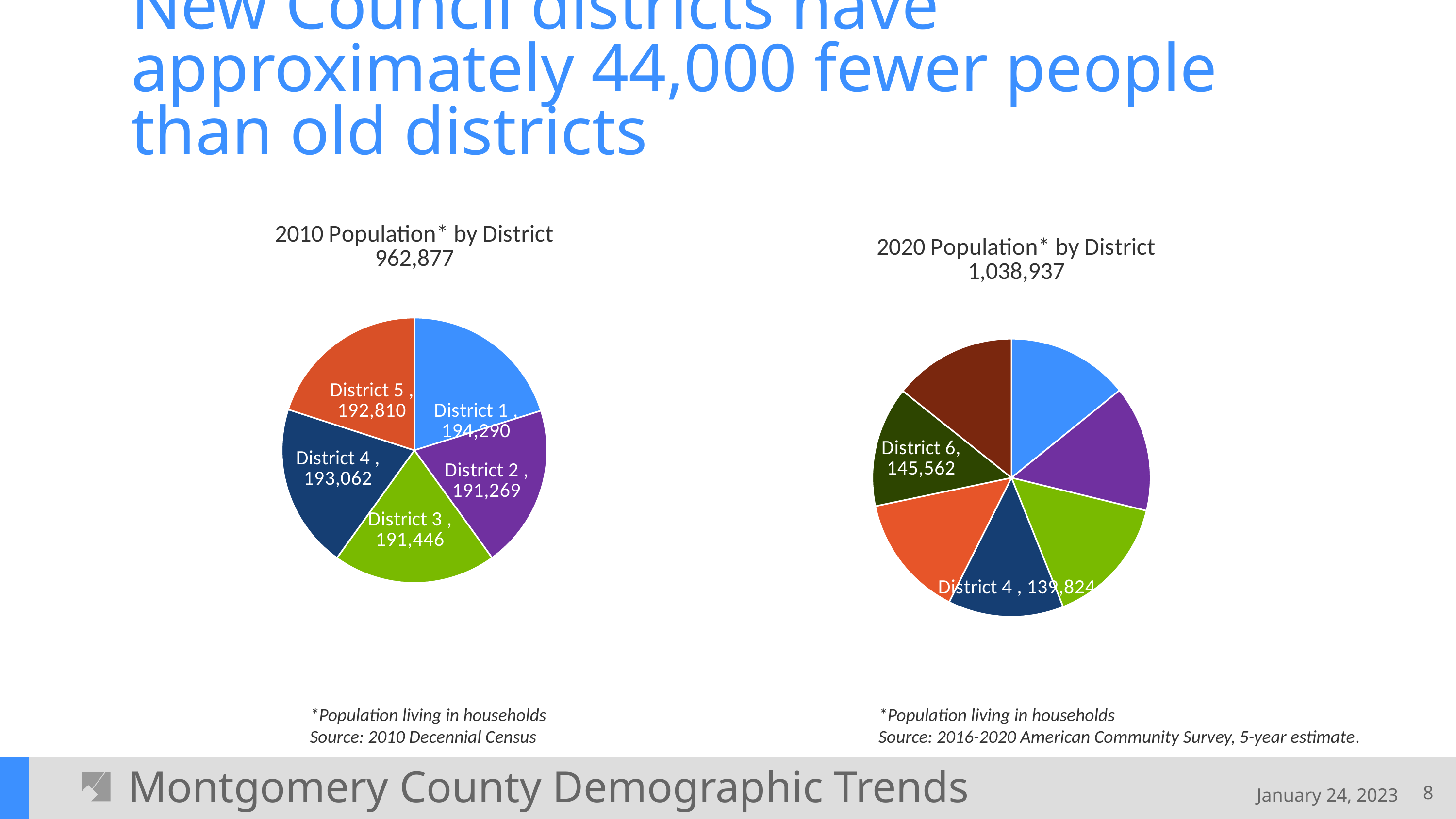
In the 2020 Population by District pie chart, what is the population of District 6? 145,562 In the 2010 Population by District pie chart, which district has the smallest population? District 2 In the 2010 Population by District pie chart, which district has the largest population? District 1 In the 2010 Population by District pie chart, which has the larger population, District 4 or District 5? District 4 In the 2010 Population by District pie chart, what is the population of District 1? 194,290 How many districts are shown in the 2010 Population by District pie chart? 5 In the 2020 Population by District pie chart, what is the population of District 4? 139,824 In the 2010 Population by District pie chart, what is the difference between the populations of District 1 and District 2? 3,021 What type of chart is used to show the 2020 Population by District? Pie chart How many slices does the 2020 Population by District pie chart have? 7 In the 2020 Population by District pie chart, what is the difference between the populations of District 6 and District 4? 5,738 In the 2010 Population by District pie chart, what is the population of District 3? 191,446